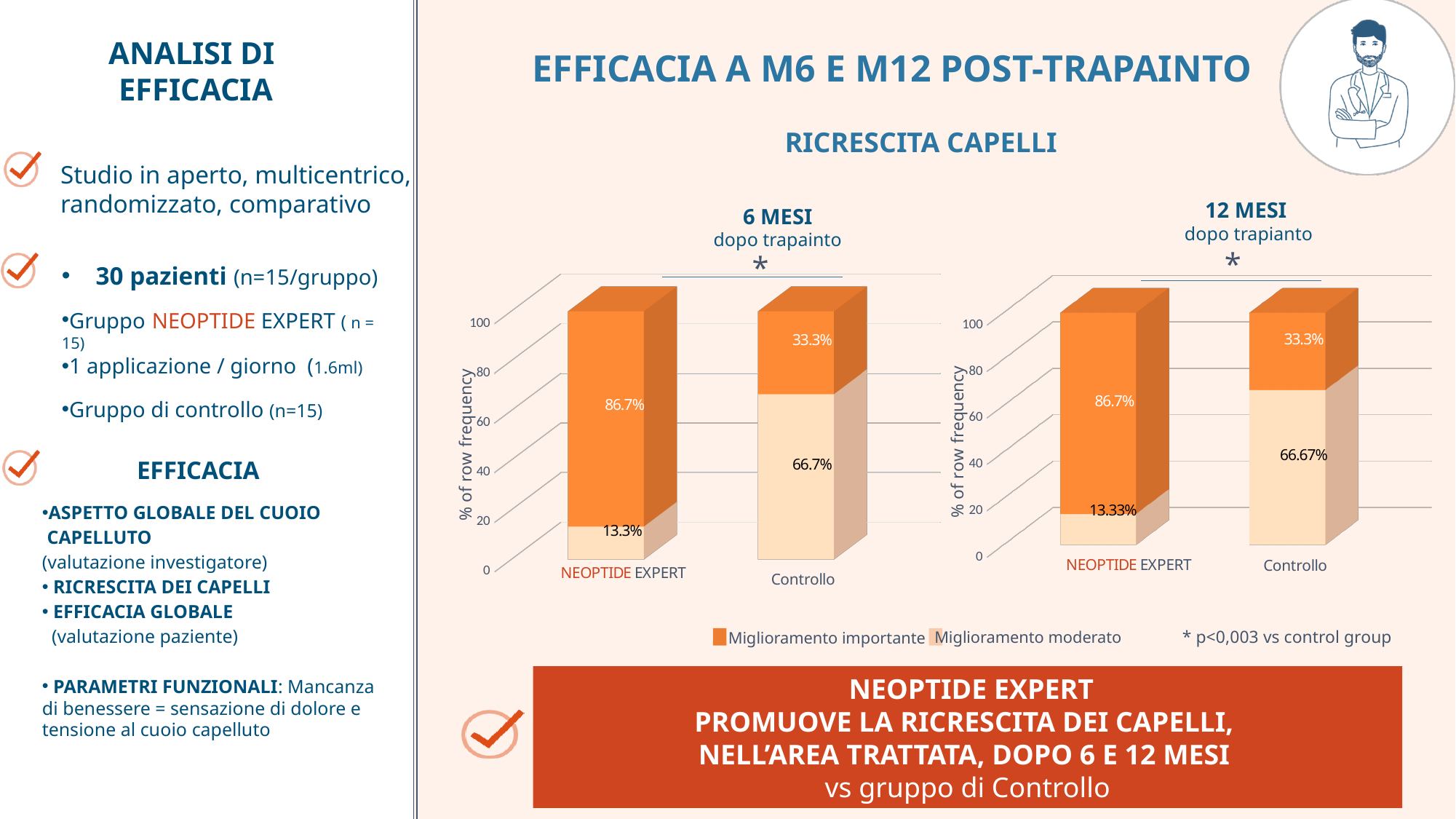
In the 6 MESI chart, which group has the higher value for Miglioramento importante, NEOPTIDE EXPERT or Controllo? NEOPTIDE EXPERT What is the label of the y axis in the 6 MESI chart? % of row frequency In the 12 MESI chart, what is the value of Miglioramento moderato for NEOPTIDE EXPERT? 13.33% How many groups are shown on the x axis of the 6 MESI chart? 2 In the 6 MESI chart, what is the difference between the Miglioramento importante values of NEOPTIDE EXPERT and Controllo? 53.4% In the 6 MESI chart, what is the value of Miglioramento moderato for Controllo? 66.7% In the 12 MESI chart, what is the value of Miglioramento importante for Controllo? 33.3% What kind of chart is the 12 MESI chart? Stacked bar chart In the 6 MESI chart, what is the value of Miglioramento importante for NEOPTIDE EXPERT? 86.7% In the 12 MESI chart, what is the value of Miglioramento moderato for Controllo? 66.67% In the 12 MESI chart, which group has the lower value for Miglioramento moderato? NEOPTIDE EXPERT How many series does the legend list for the charts? 2